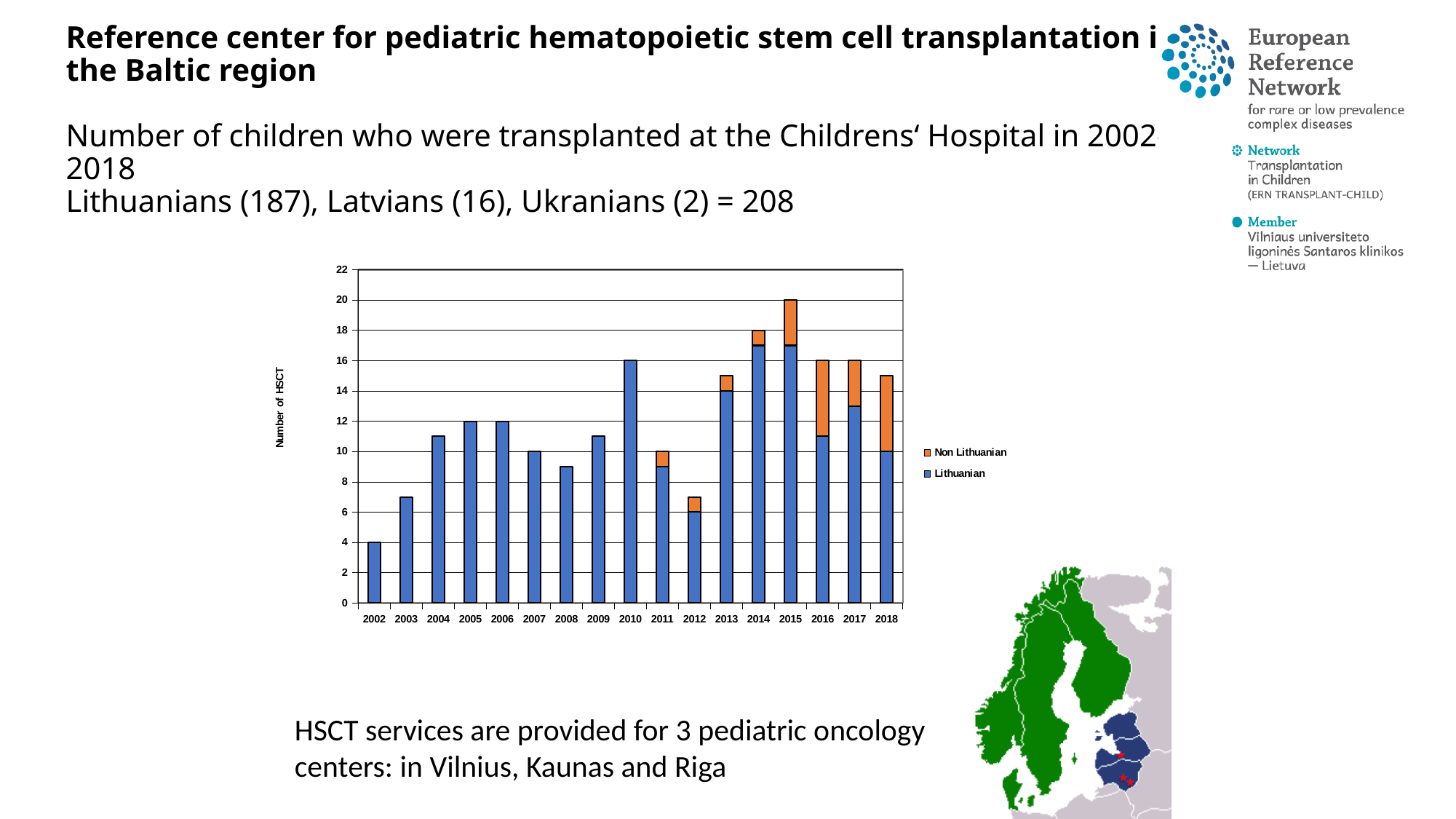
How many years are shown on the x axis of the chart? 17 Which year has a larger total number of HSCT, 2010 or 2012? 2010 What is the difference between the total number of HSCT in 2015 and in 2002? 16 What is the label on the y axis of the chart? Number of HSCT How many series does the chart legend list? 2 What is the total number of HSCT in 2002? 4 What is the total number of HSCT in 2015? 20 Which year has the lowest total number of HSCT? 2002 What type of chart is shown on the slide? Stacked bar chart Which year has the highest total number of HSCT? 2015 Is the total number of HSCT in 2003 greater or less than 8? less What is the number of HSCT in 2010? 16